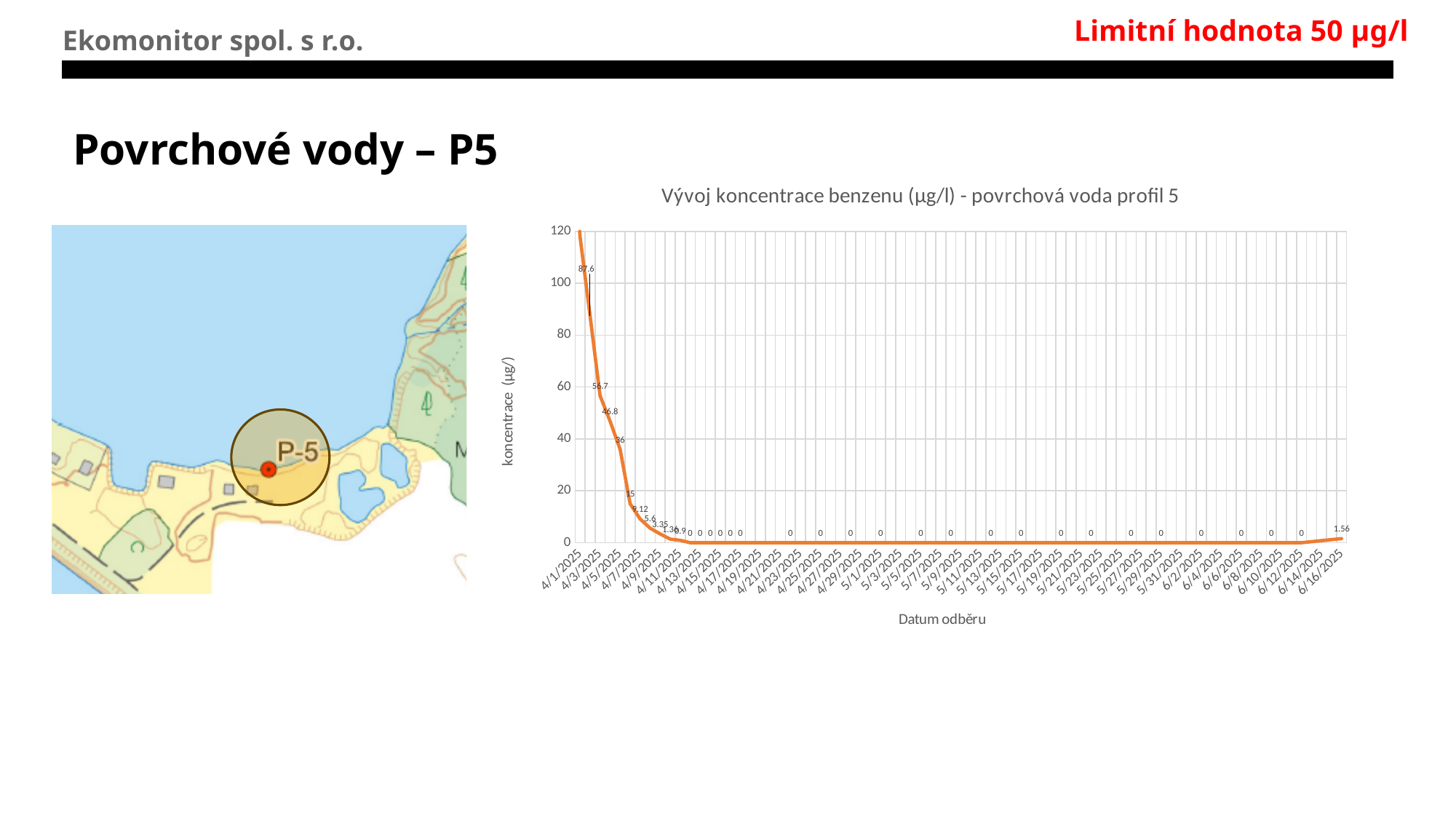
Which date has the highest plotted concentration? 4/1/2025 What is the title of the chart? Vývoj koncentrace benzenu (µg/l) - povrchová voda profil 5 What kind of chart is shown on the slide? line chart Is the value for 6/16/2025 greater or less than 20? less Which is larger, the value for 4/1/2025 or the value for 6/16/2025? 4/1/2025 Do the values generally rise or fall along the x axis from 4/1/2025 to 5/1/2025? fall What is the benzene concentration value plotted for 6/16/2025? 1.56 Is the value for 5/1/2025 greater or less than 20? less What is the label of the x axis of the chart? Datum odběru Is the value for 4/1/2025 greater or less than 100? greater How many data series are plotted in the chart? 1